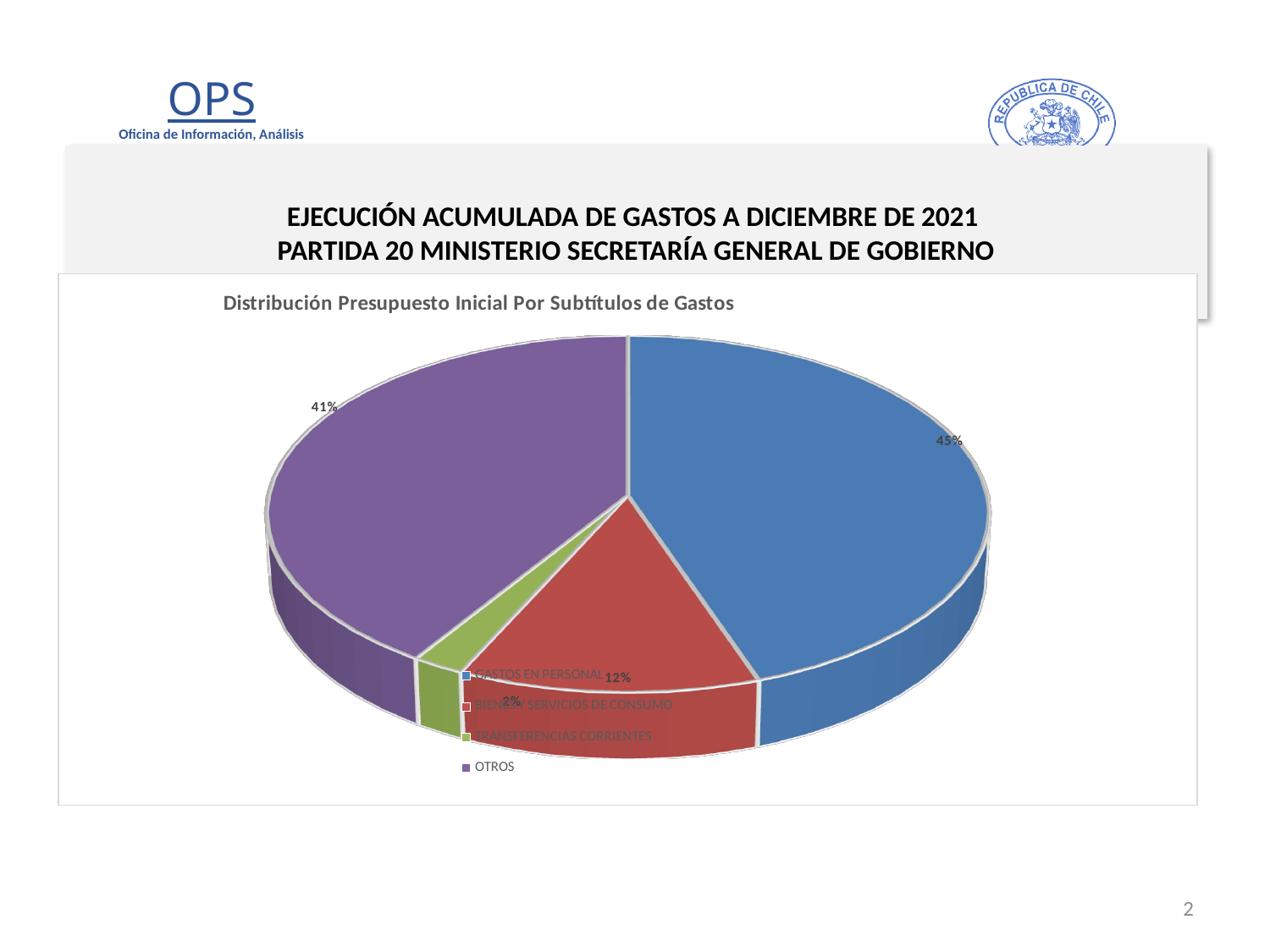
Which category has the smallest slice of the pie? TRANSFERENCIAS CORRIENTES What is the chart's title? Distribución Presupuesto Inicial Por Subtítulos de Gastos What share of the pie does BIENES Y SERVICIOS DE CONSUMO represent? 12% What share of the pie does OTROS represent? 41% What share of the pie does TRANSFERENCIAS CORRIENTES represent? 2% What kind of chart is shown on the slide? Pie chart What is the difference in percentage points between GASTOS EN PERSONAL and OTROS? 4 percentage points Which category has the largest slice of the pie? GASTOS EN PERSONAL Which is larger, the share for BIENES Y SERVICIOS DE CONSUMO or the share for TRANSFERENCIAS CORRIENTES? BIENES Y SERVICIOS DE CONSUMO How many categories does the pie chart show? 4 What colour is the slice for OTROS? Purple